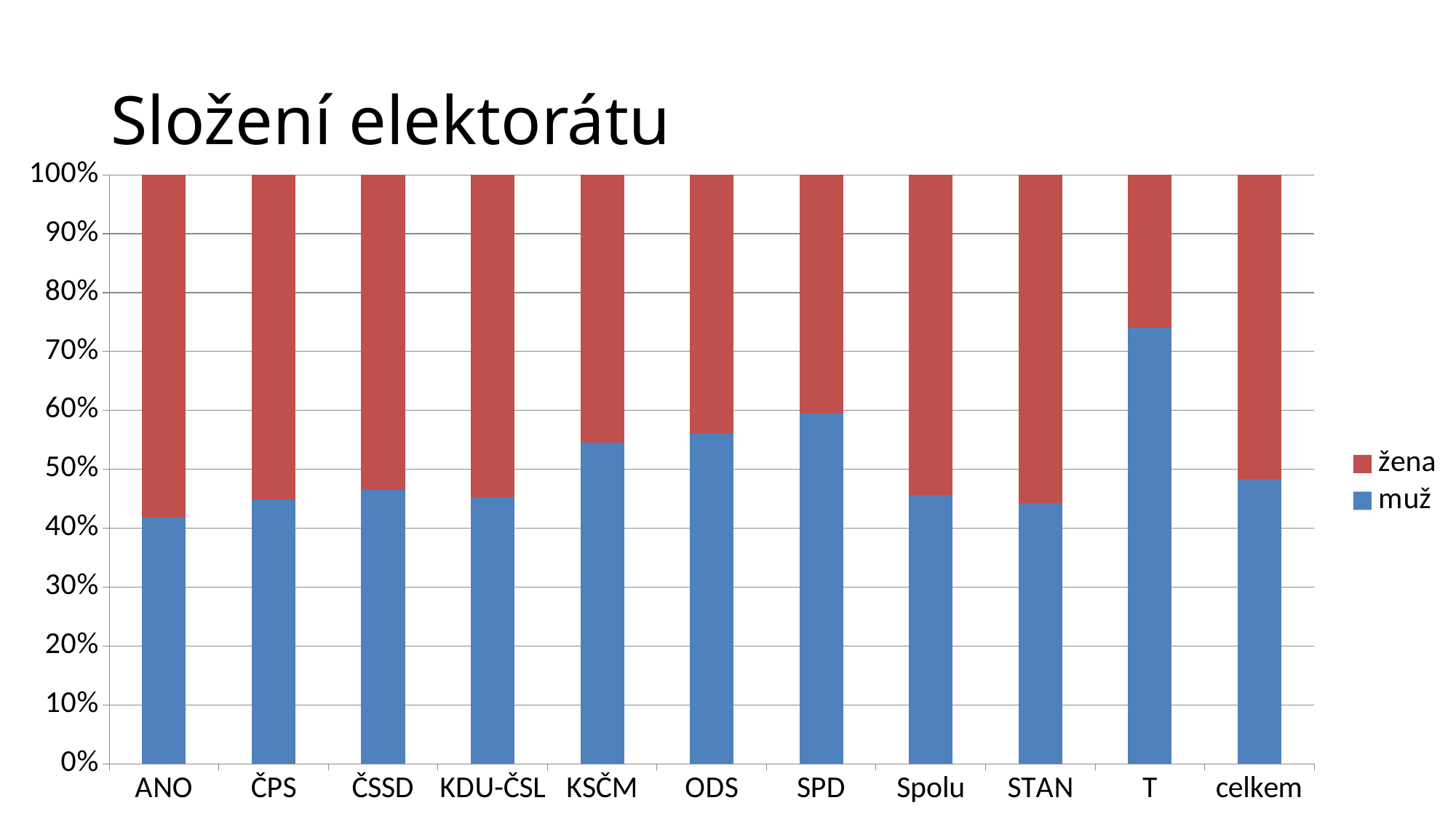
Which category has the largest share of muž? T How many series does the legend list? 2 How many categories are shown along the x axis of the chart? 11 What is the title of the chart? Složení elektorátu What kind of chart is shown on the slide? stacked bar chart Is the muž share for ODS greater or less than 50%? greater Is the muž share for T greater or less than 70%? greater Which colour represents the žena series in the legend? red Which has a larger muž share, SPD or STAN? SPD Which category has the smallest share of žena? T Which category has the largest share of žena? ANO Is the muž share for ANO greater or less than 50%? less